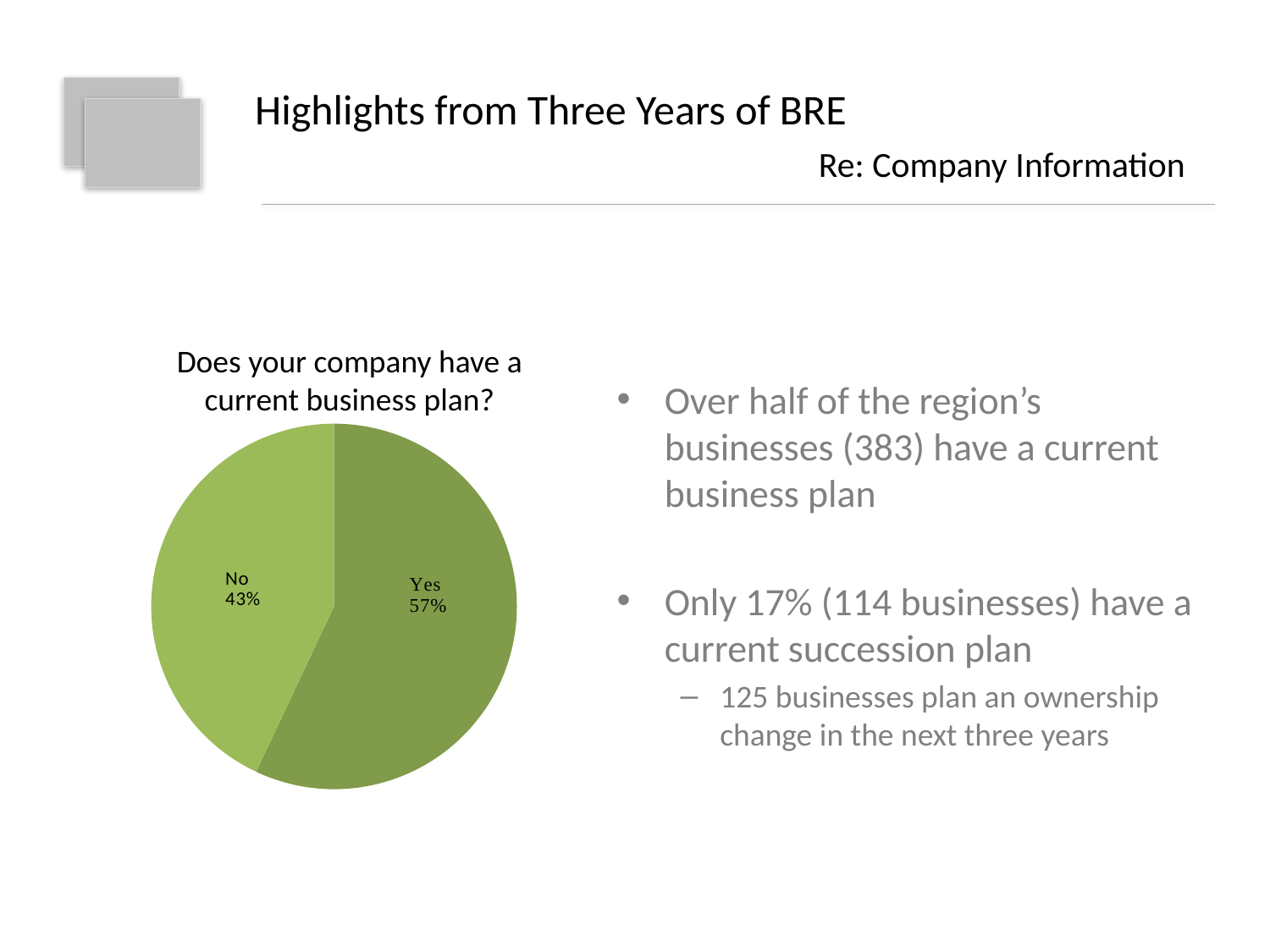
Which slice of the pie is the smallest? No Which slice of the pie is the largest? Yes How many slices does the pie chart have? 2 Is the share for No greater or less than 50%? less What share of the pie is labelled "No"? 43% What is the difference in percentage points between the Yes and No slices? 14 What is the total of the two slice percentages shown on the pie? 100% What kind of chart is shown on the slide? Pie chart Which is larger, the Yes slice or the No slice? Yes Is the share for Yes greater or less than 50%? greater What is the title of the chart? Does your company have a current business plan? What share of the pie is labelled "Yes"? 57%